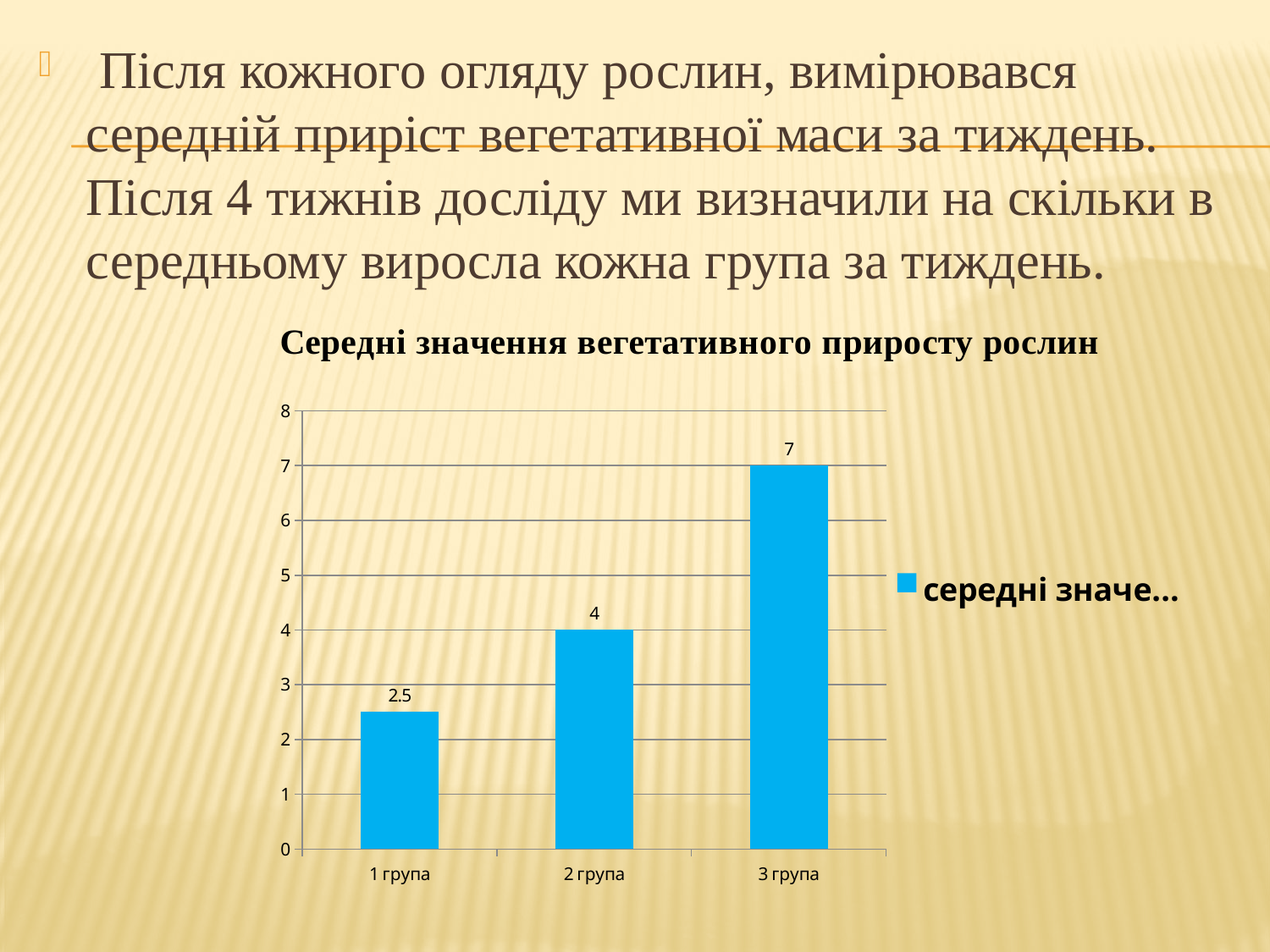
What is the value for 2 група? 4 Do the values rise or fall from 1 група to 3 група? rise Which group has the highest value? 3 група What is the difference between the values for 3 група and 1 група? 4.5 What is the value for 3 група? 7 How many groups are shown on the chart? 3 Which group has the lowest value? 1 група What is the difference between the values for 2 група and 1 група? 1.5 What is the value for 1 група? 2.5 What kind of chart is shown on the slide? bar chart Is the value for 3 група greater or less than 6? greater Which is larger, the value for 2 група or the value for 3 група? 3 група